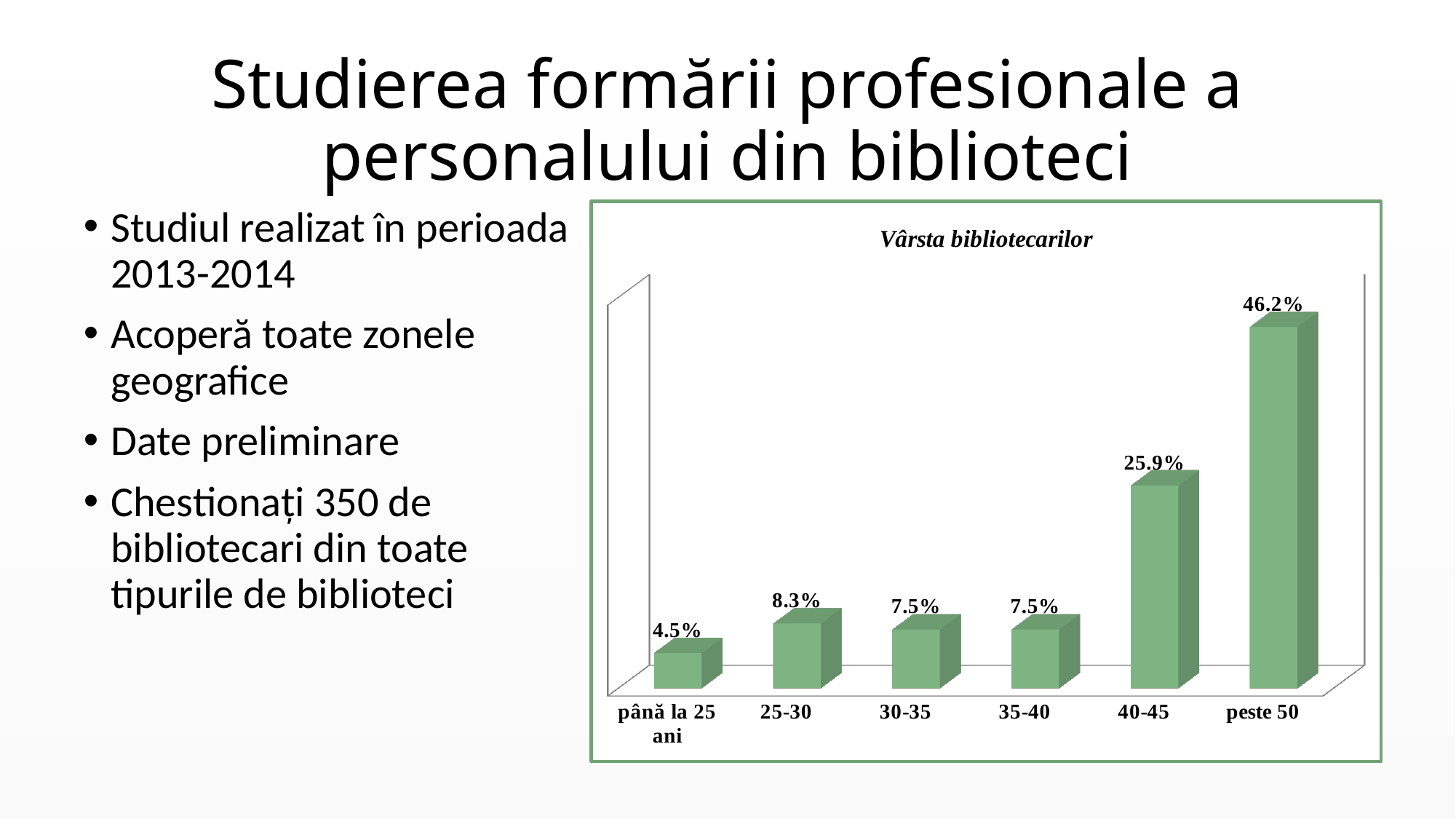
What is the title of the chart? Vârsta bibliotecarilor What is the value for the 'peste 50' age group? 46.2% How many age groups are shown on the chart? 6 What is the difference between the values for 'peste 50' and '40-45'? 20.3% What is the value for the '40-45' age group? 25.9% Which is larger, the value for '25-30' or the value for '30-35'? 25-30 Which age group has the highest value? peste 50 What is the value for the 'până la 25 ani' age group? 4.5% Which age group has the lowest value? până la 25 ani What is the value for the '25-30' age group? 8.3% What kind of chart is shown on the slide? bar chart What is the difference between the values for '25-30' and 'până la 25 ani'? 3.8%